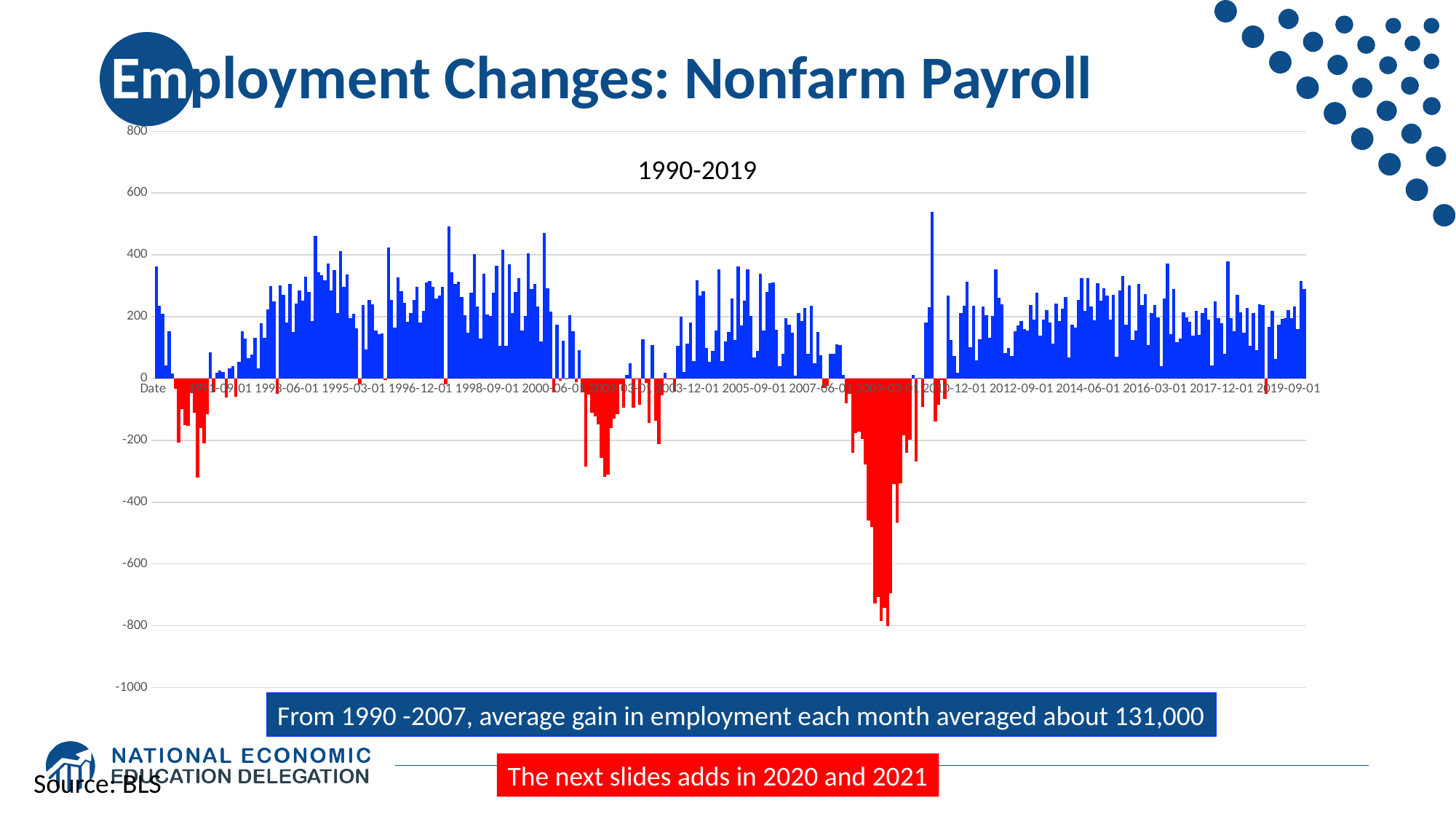
Is the highest bar on the chart, around 2010, greater or less than 400? greater What kind of chart is shown on the slide? bar chart What colour are the bars for months with negative employment changes? red Is the value for the bar at the 2019-09-01 label greater or less than 400? less Are the negative bars around 2002-03-01 greater or less than -400? greater What is the title of the chart? 1990-2019 Around which x-axis date label does the deepest cluster of negative bars occur? 2009-03-01 What is the highest value shown on the vertical axis? 800 Which period has the larger negative bars: around 2002-03-01 or around 2009-03-01? around 2009-03-01